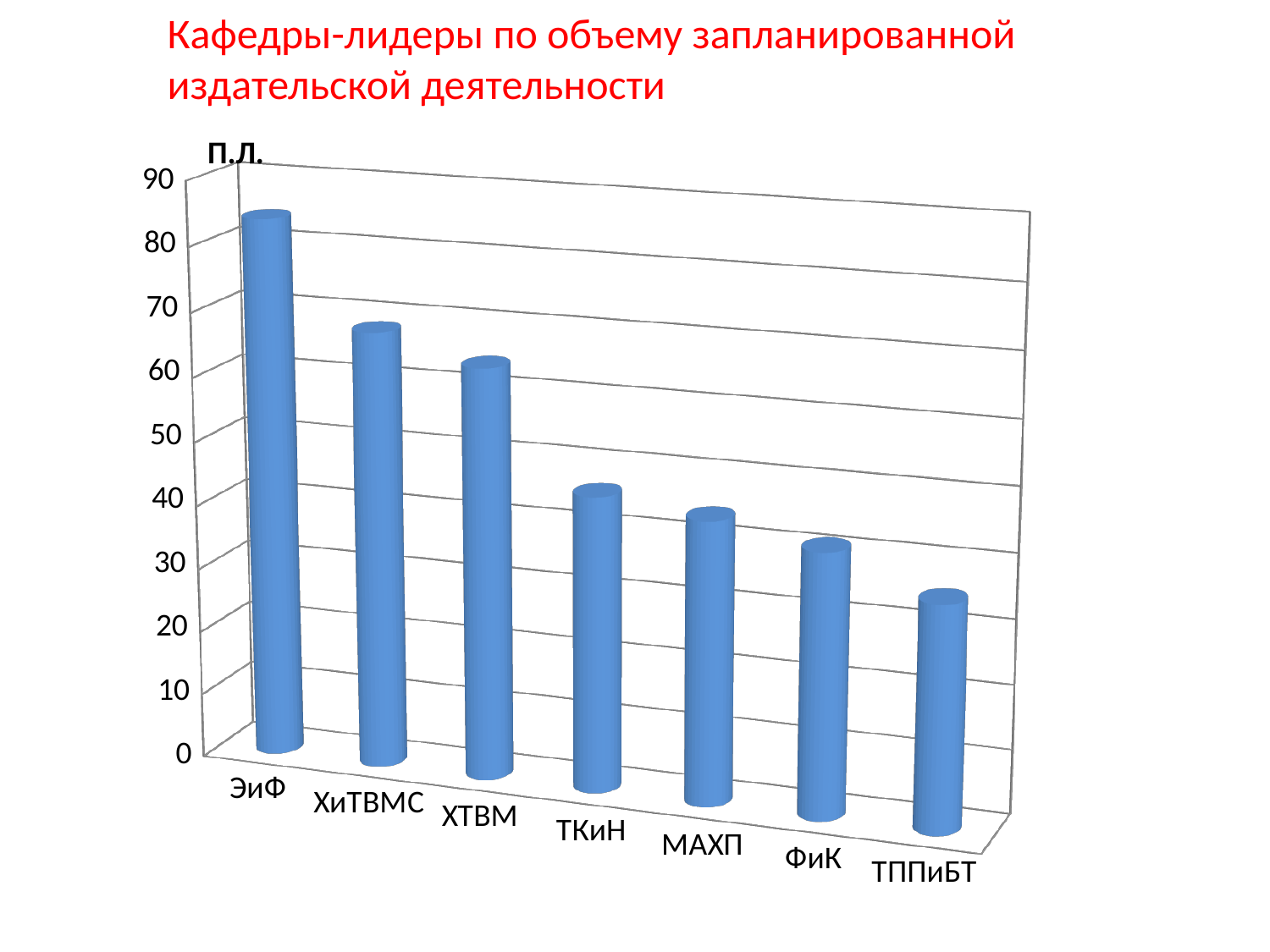
What unit label is shown at the top of the vertical axis? п.л. Do the values rise or fall from left to right along the x axis? fall Is the value for ФиК greater or less than 60? less Which is larger, the value for ЭиФ or the value for ТКиН? ЭиФ Which department has the highest value on the chart? ЭиФ Which is larger, the value for ХТВМ or the value for ФиК? ХТВМ Is the value for ТППиБТ greater or less than 50? less Is the value for ЭиФ greater or less than 70? greater Which department has the lowest value on the chart? ТППиБТ What kind of chart is shown on the slide? bar chart How many departments (categories) are shown on the chart? 7